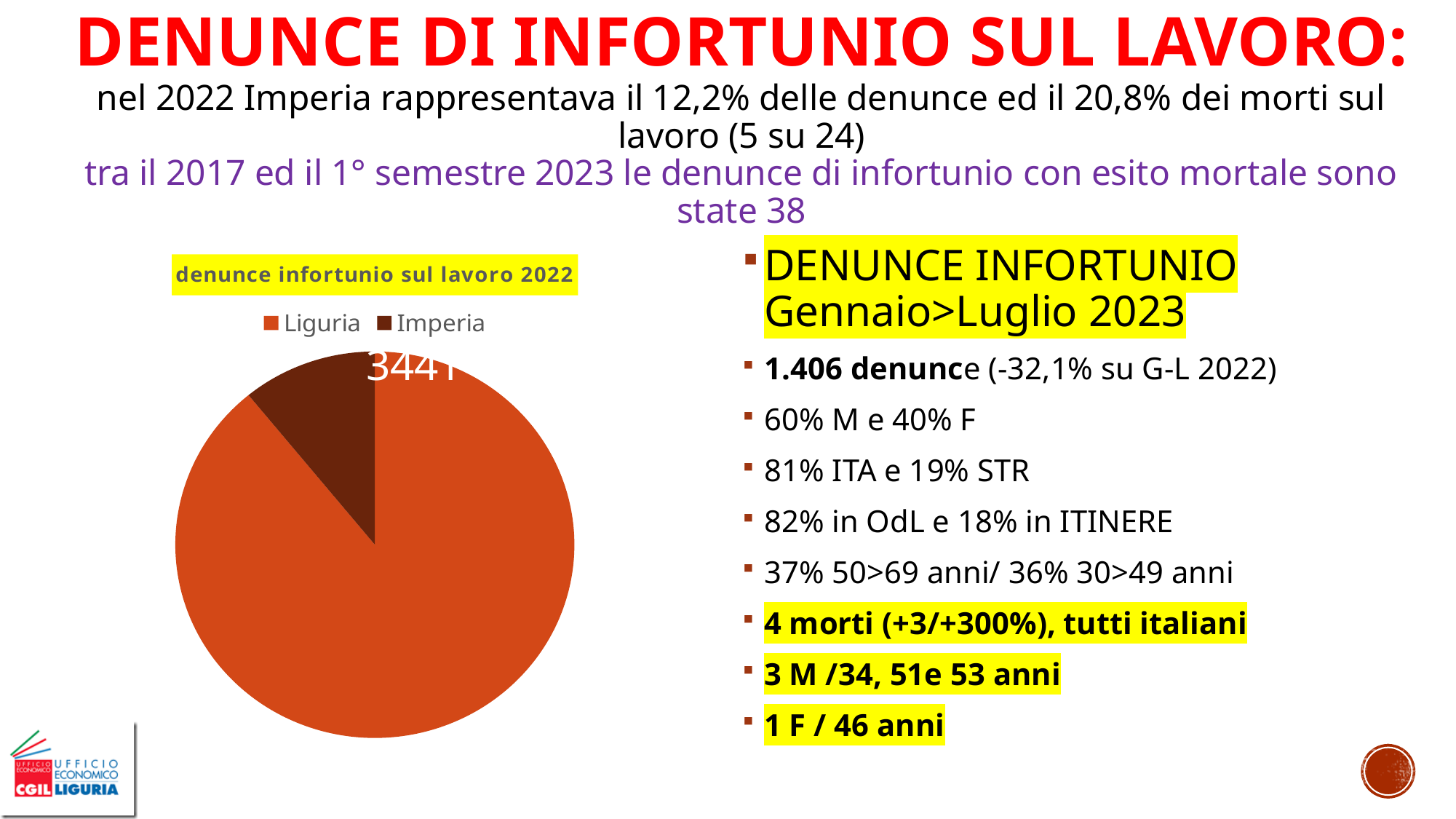
How many slices does the pie chart have? 2 What is the title of the pie chart? denunce infortunio sul lavoro 2022 Which category has the smallest slice in the pie chart? Imperia Which colour represents Imperia in the pie chart? dark brown Which slice is larger in the pie chart, Liguria or Imperia? Liguria How many entries does the legend of the pie chart list? 2 What kind of chart is shown on the slide? pie chart Is the Imperia slice greater or less than half of the pie? less Which category has the largest slice in the pie chart? Liguria